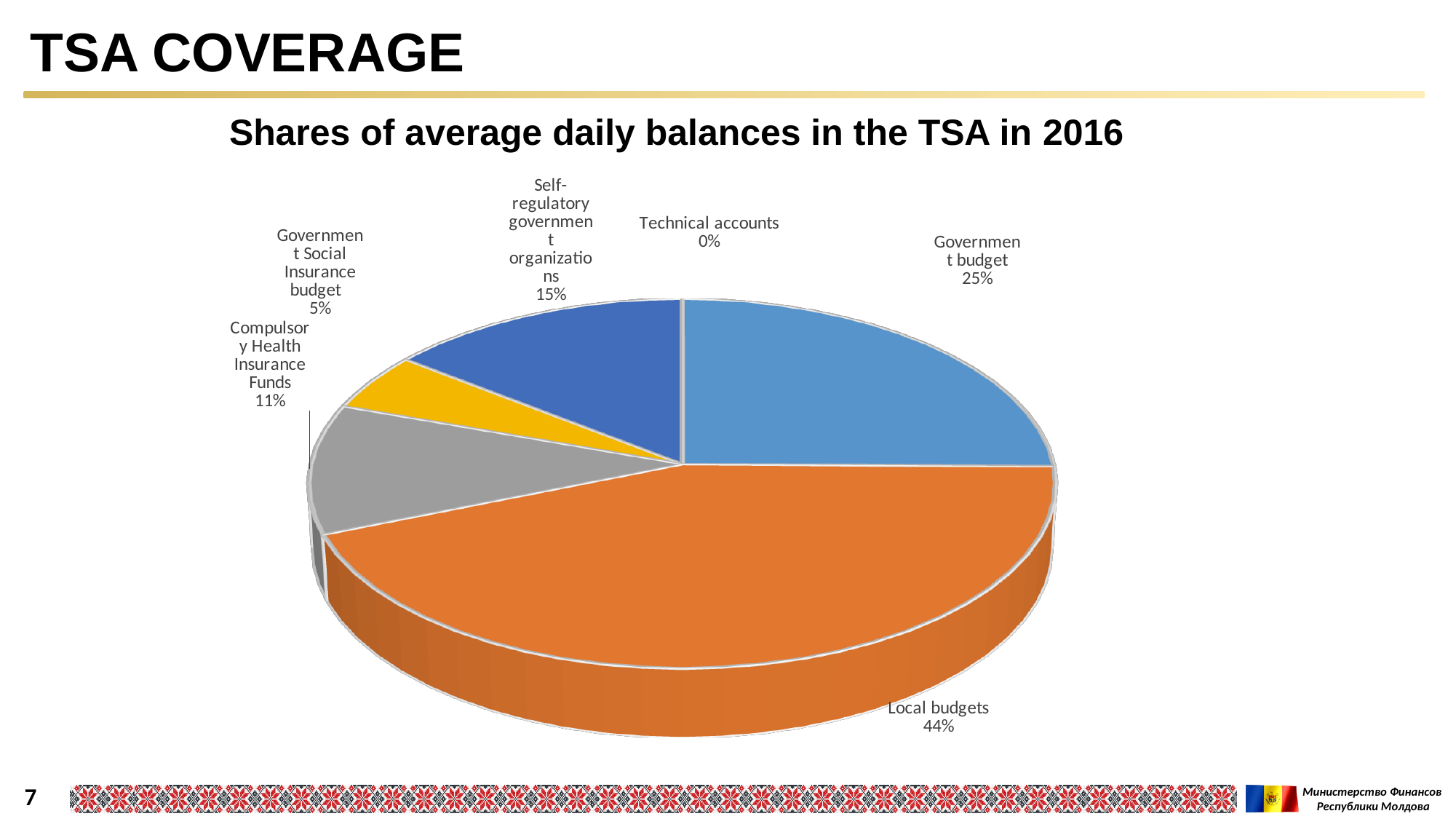
How many categories are labelled on the pie chart? 6 What share is shown for Compulsory Health Insurance Funds? 11% What share is shown for Self-regulatory government organizations? 15% What share is shown for the Government Social Insurance budget? 5% What share is shown for Technical accounts? 0% What share does the Government budget hold in the pie chart? 25% Which category has the smallest share of the pie? Technical accounts Which has a larger share: Compulsory Health Insurance Funds or Self-regulatory government organizations? Self-regulatory government organizations What share of average daily balances in the TSA in 2016 is held by Local budgets? 44% What is the difference in percentage points between the Local budgets share and the Government budget share? 19 Which category has the largest share of the pie? Local budgets What type of chart is shown on the slide? Pie chart